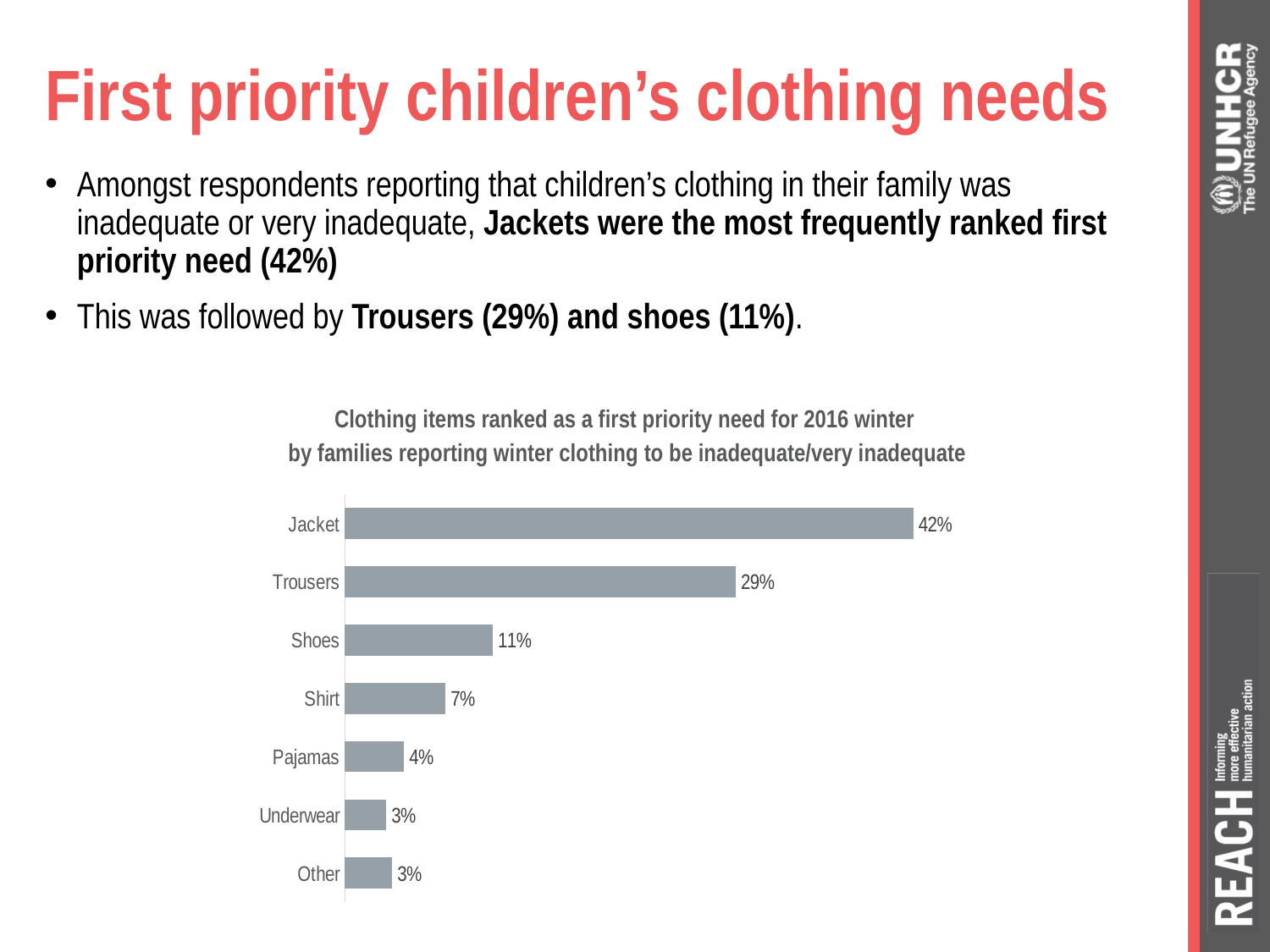
What is the value shown for Trousers? 29% What is the title of the chart? Clothing items ranked as a first priority need for 2016 winter by families reporting winter clothing to be inadequate/very inadequate What percentage is shown for Shoes? 11% Which has a larger value, Shirt or Pajamas? Shirt What is the value for Pajamas? 4% What is the difference between the values for Shoes and Shirt? 4% Which two categories share the same value of 3%? Underwear and Other What percentage of families ranked Jacket as a first priority need? 42% What kind of chart is shown on the slide? Bar chart What is the difference between the values for Jacket and Trousers? 13% Which clothing item has the highest percentage? Jacket How many clothing categories are shown in the chart? 7